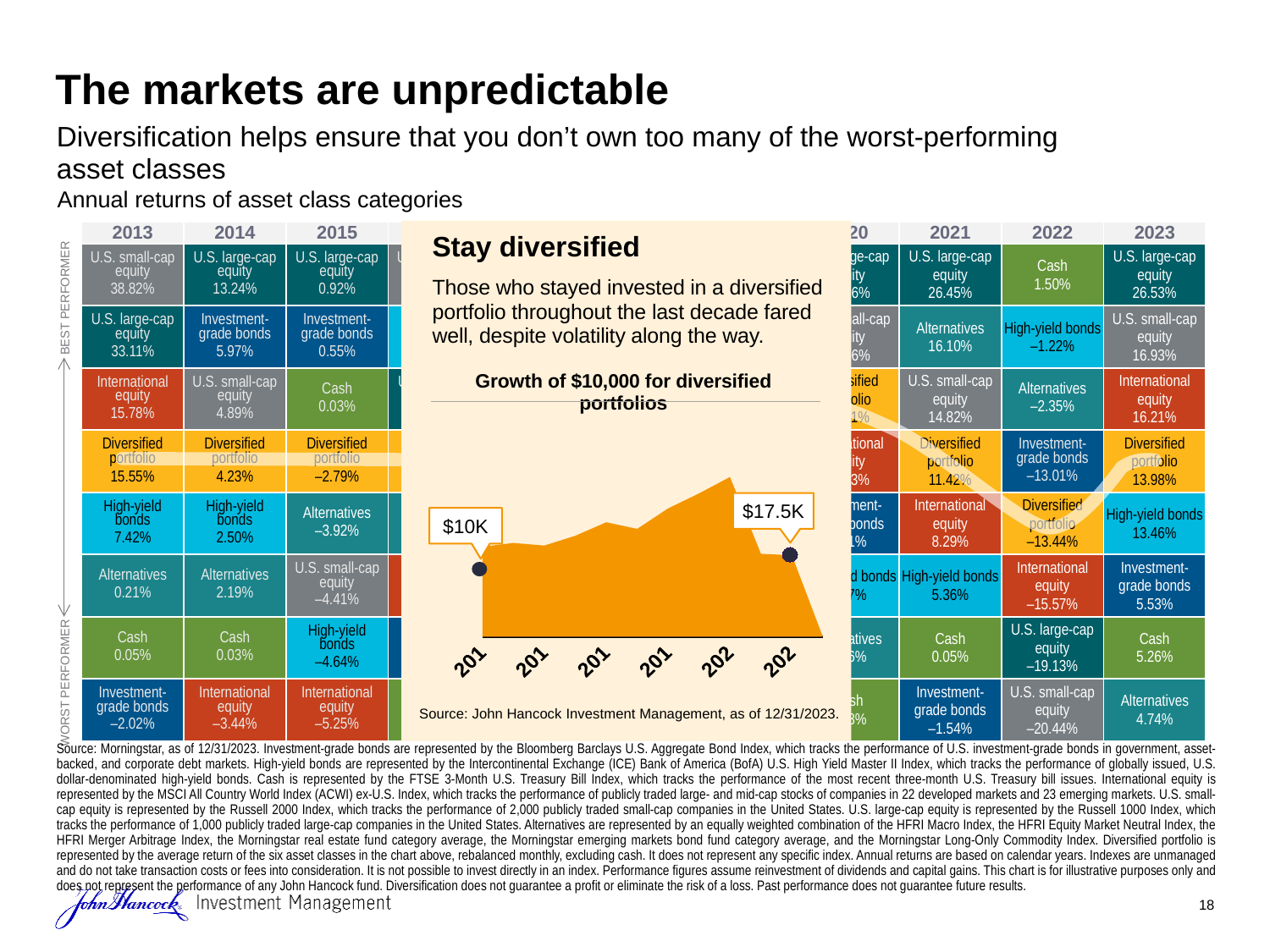
In the annual returns table, what is the difference between the 2023 returns of U.S. large-cap equity (26.53%) and U.S. small-cap equity (16.93%)? 9.60 percentage points In the 'Growth of $10,000 for diversified portfolios' chart, does the value overall rise or fall from the start to the end of the period? Rise What is the source cited beneath the 'Growth of $10,000 for diversified portfolios' chart? John Hancock Investment Management, as of 12/31/2023 In the annual returns table, what was the return of U.S. small-cap equity in 2013? 38.82% In the annual returns table, what was the return of the diversified portfolio in 2023? 13.98% What kind of chart is the 'Growth of $10,000 for diversified portfolios' chart? Area chart In the annual returns table, which asset class was the worst performer in 2022? U.S. small-cap equity In the annual returns table, was the diversified portfolio's return higher in 2013 or in 2014? 2013 In the 'Growth of $10,000 for diversified portfolios' chart, what is the starting value labeled on the chart? $10K In the annual returns table, which asset class was the best performer in 2013? U.S. small-cap equity In the 'Growth of $10,000 for diversified portfolios' chart, what is the ending value labeled on the chart? $17.5K In the annual returns table, what was the return of cash in 2022? 1.50%